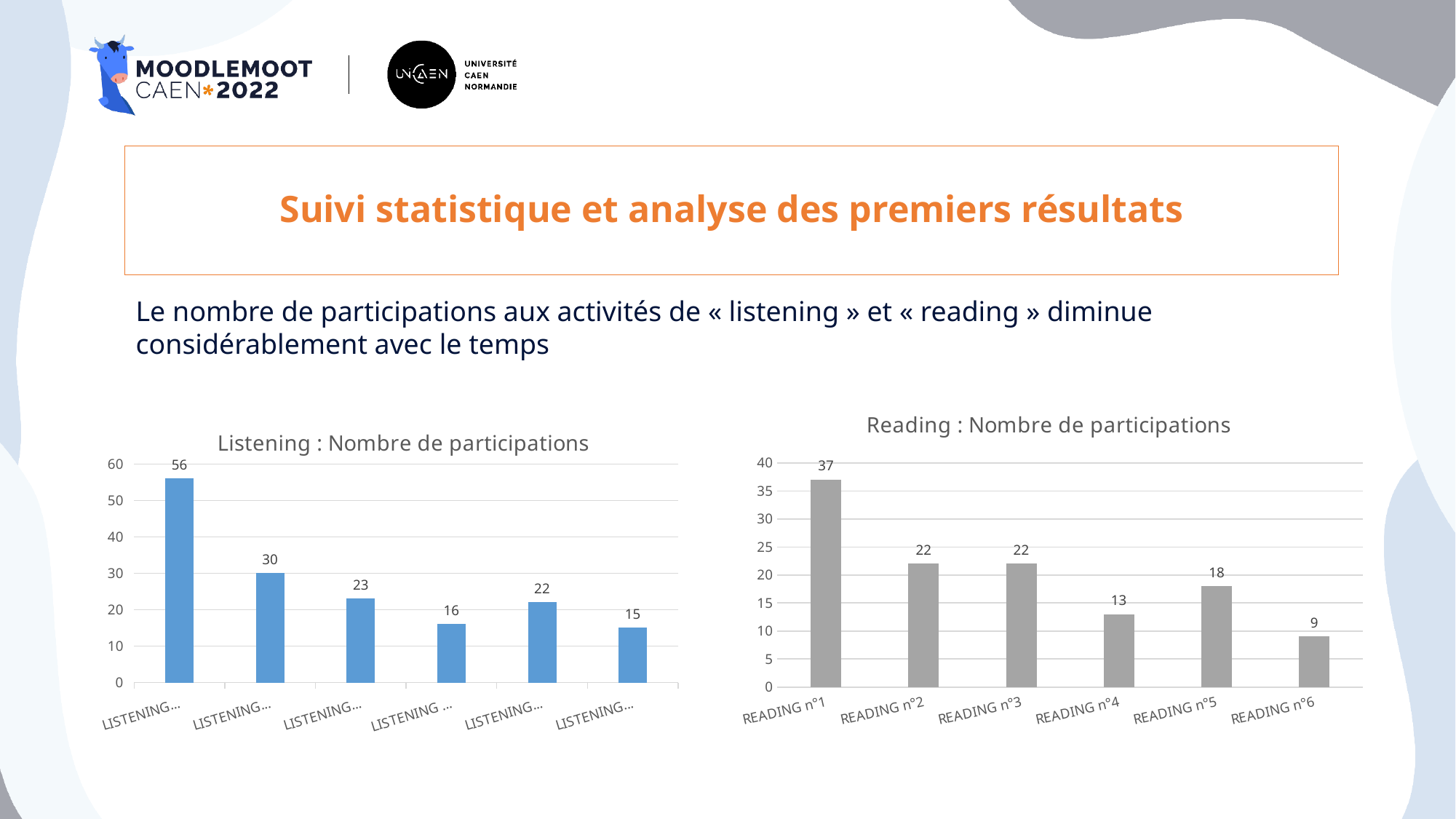
In the 'Reading : Nombre de participations' chart, what is the difference between READING n°1 and READING n°2? 15 In the 'Reading : Nombre de participations' chart, which is larger, READING n°4 or READING n°5? READING n°5 What colour are the bars in the 'Reading : Nombre de participations' chart? Grey In the 'Listening : Nombre de participations' chart, what is the lowest value shown? 15 In the 'Reading : Nombre de participations' chart, what is the value for READING n°6? 9 In the 'Reading : Nombre de participations' chart, what is the value for READING n°4? 13 What kind of chart is the 'Listening : Nombre de participations' chart? Bar chart In the 'Reading : Nombre de participations' chart, which category has the lowest value? READING n°6 How many categories are shown in the 'Reading : Nombre de participations' chart? 6 In the 'Reading : Nombre de participations' chart, which category has the highest value? READING n°1 In the 'Reading : Nombre de participations' chart, what is the value for READING n°1? 37 In the 'Listening : Nombre de participations' chart, what is the highest value shown? 56